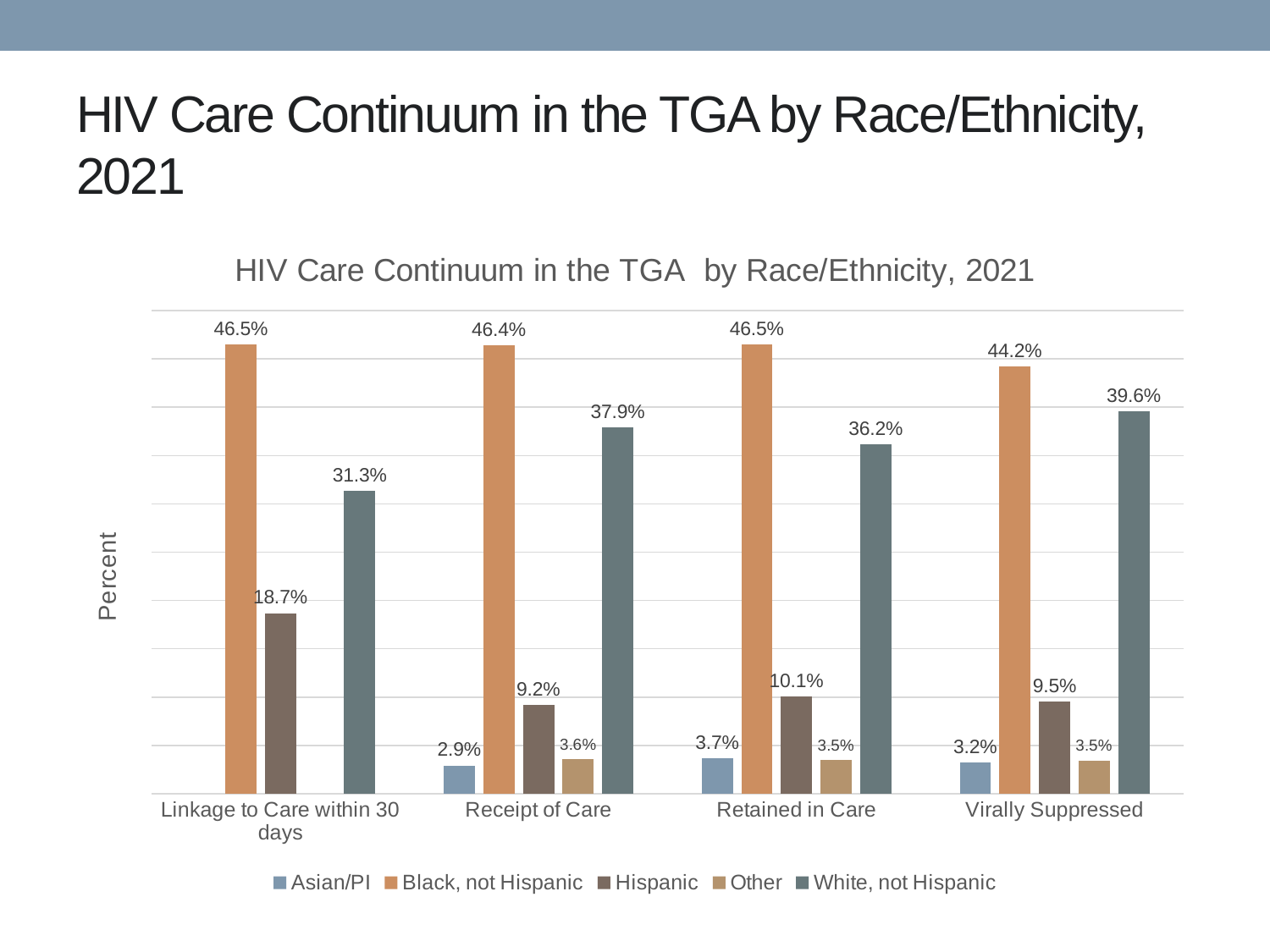
How many series does the legend list? 5 What is the value for Asian/PI in the Receipt of Care category? 2.9% What is the difference between the Hispanic values for Linkage to Care within 30 days and Receipt of Care? 9.5% What is the value for Black, not Hispanic in the Linkage to Care within 30 days category? 46.5% Which is larger: the White, not Hispanic value for Receipt of Care or for Retained in Care? Receipt of Care What is the value for White, not Hispanic in the Virally Suppressed category? 39.6% What is the difference between the Black, not Hispanic and White, not Hispanic values in the Linkage to Care within 30 days category? 15.2% Which race/ethnicity group has the lowest value in the Receipt of Care category? Asian/PI What kind of chart is shown on the slide? Bar chart How many categories are shown on the x axis? 4 What is the value for Hispanic in the Retained in Care category? 10.1% Which race/ethnicity group has the highest value in the Virally Suppressed category? Black, not Hispanic